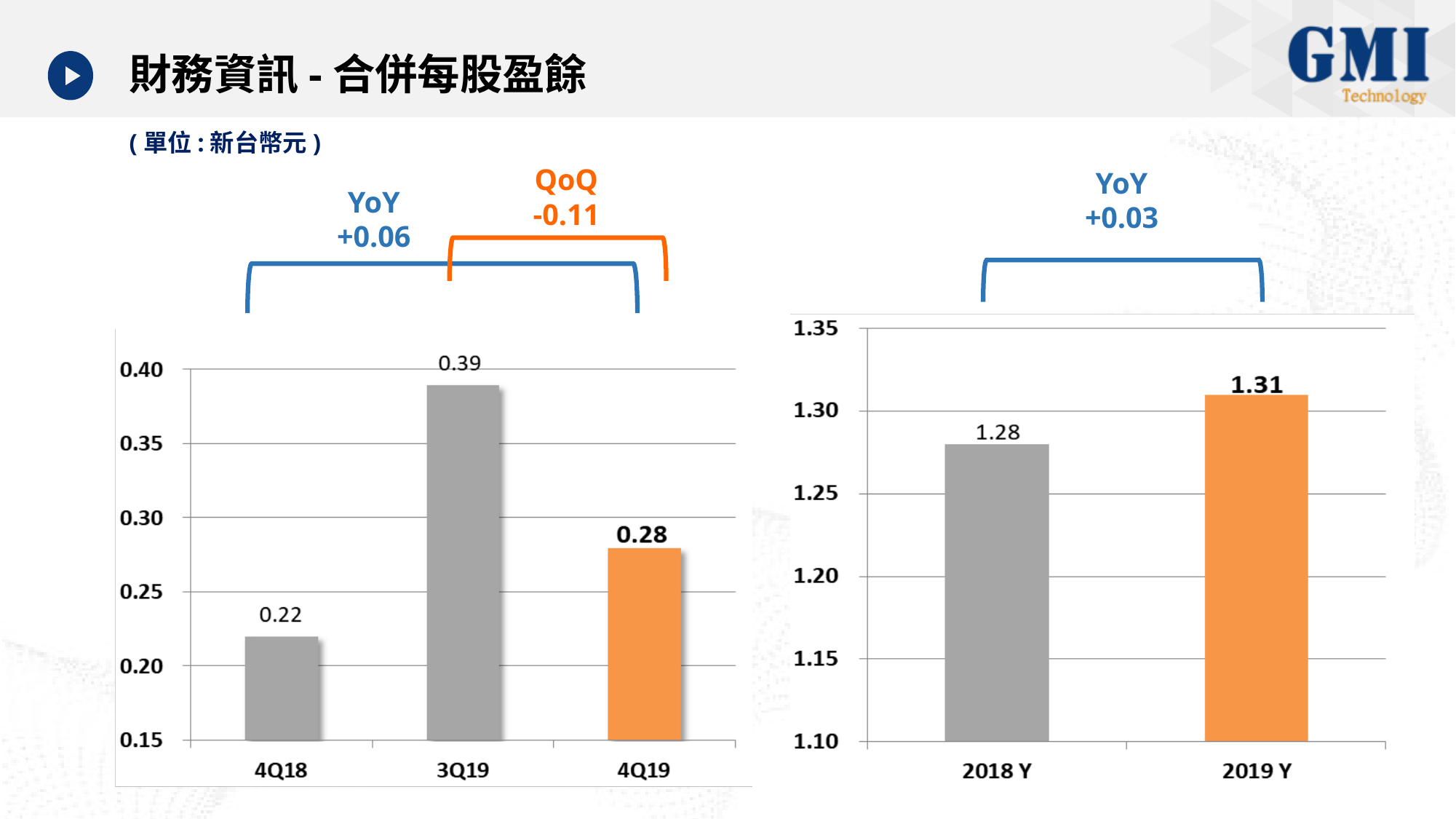
In the left (quarterly) chart, what is the value for 4Q18? 0.22 In the right (annual) chart, which is larger, 2018 Y or 2019 Y? 2019 Y In the right (annual) chart, what is the value for 2019 Y? 1.31 In the right (annual) chart, what is the difference between the 2019 Y and 2018 Y values? 0.03 In the left (quarterly) chart, what is the difference between the 3Q19 and 4Q19 values? 0.11 What kind of chart is the right (annual) chart? bar chart In the left (quarterly) chart, which quarter has the lowest value? 4Q18 In the left (quarterly) chart, what colour is the 4Q19 bar? orange In the left (quarterly) chart, what is the value for 3Q19? 0.39 In the left (quarterly) chart, is the value for 4Q19 greater or less than 0.30? less How many bars are in the left (quarterly) chart? 3 In the left (quarterly) chart, which quarter has the highest value? 3Q19